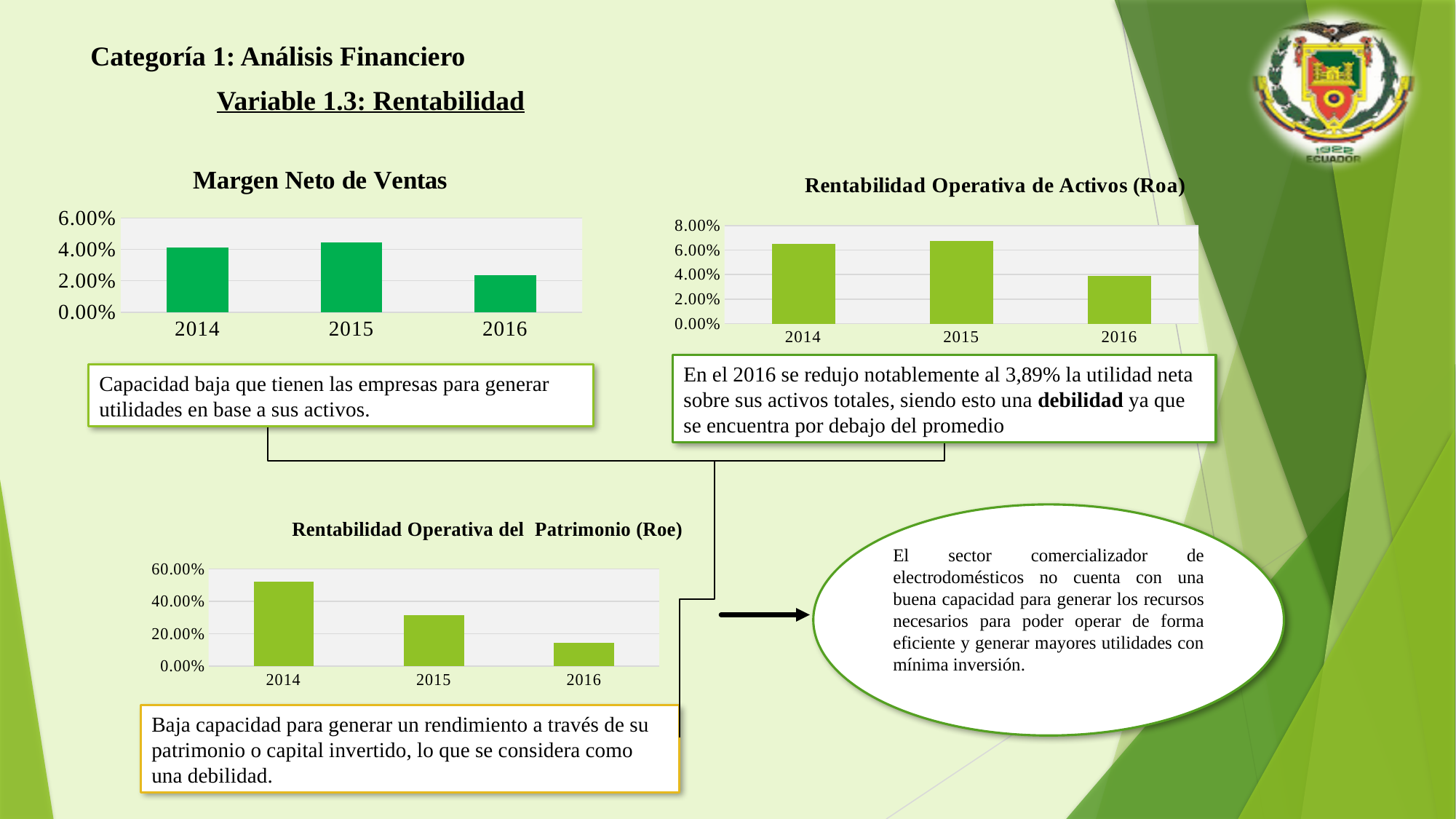
How many years are shown on the "Rentabilidad Operativa del Patrimonio (Roe)" chart? 3 In the "Rentabilidad Operativa del Patrimonio (Roe)" chart, do the values rise or fall from 2014 to 2016? fall In the "Rentabilidad Operativa del Patrimonio (Roe)" chart, is the value for 2016 greater or less than 20.00%? less In the "Margen Neto de Ventas" chart, is the value for 2016 greater or less than 4.00%? less In the "Rentabilidad Operativa del Patrimonio (Roe)" chart, which year has the lowest value? 2016 In the "Rentabilidad Operativa de Activos (Roa)" chart, which year has the lowest value? 2016 In the "Rentabilidad Operativa del Patrimonio (Roe)" chart, is the value for 2014 greater or less than 40.00%? greater In the "Rentabilidad Operativa de Activos (Roa)" chart, which is larger, the value for 2015 or the value for 2016? 2015 In the "Rentabilidad Operativa del Patrimonio (Roe)" chart, which year has the highest value? 2014 What kind of chart is the "Margen Neto de Ventas" chart? bar chart In the "Margen Neto de Ventas" chart, which year has the lowest value? 2016